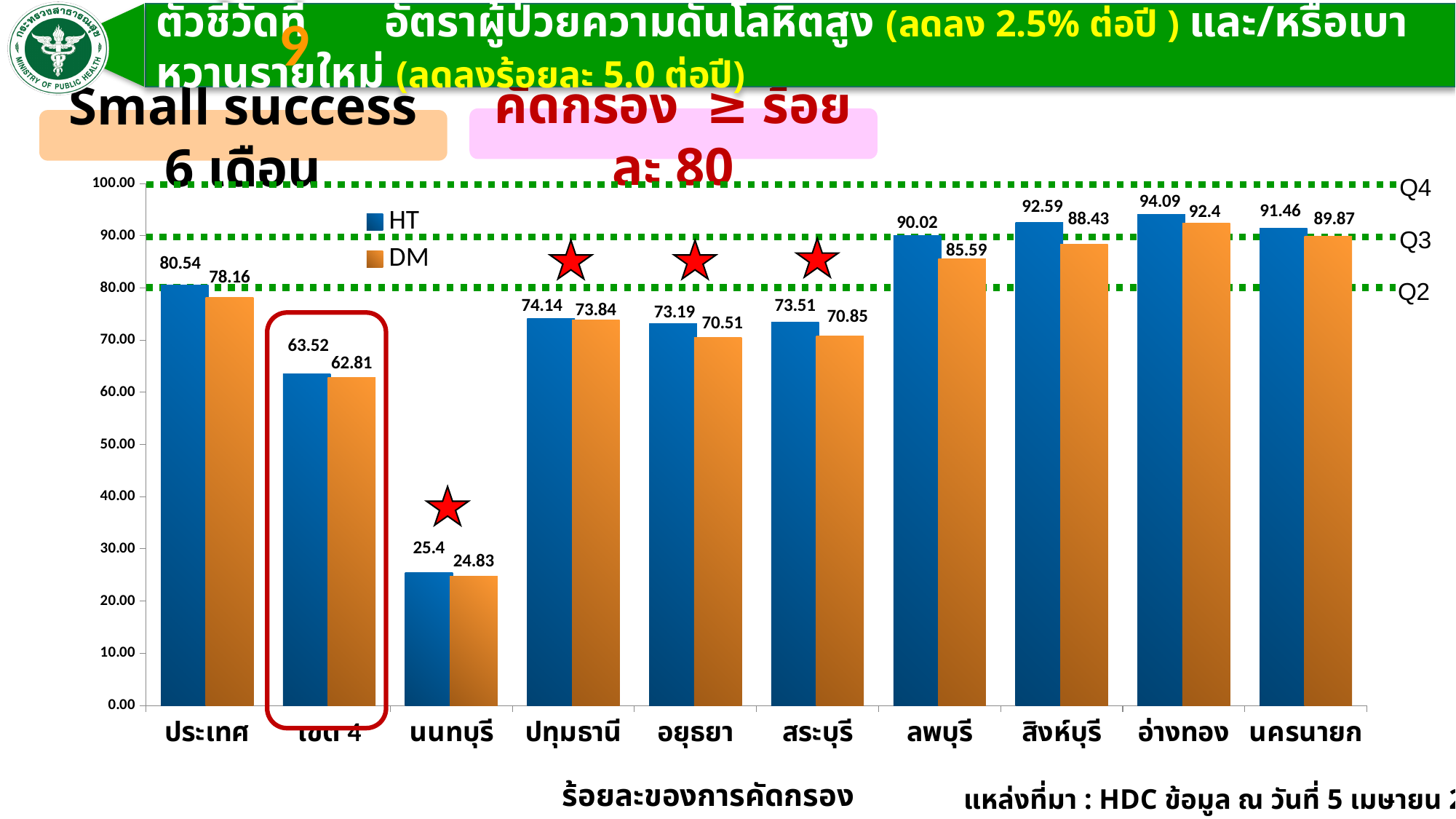
Is the DM value for เขต 4 greater or less than 70? less Which is larger, the HT value for สิงห์บุรี or the HT value for นครนายก? สิงห์บุรี What is the HT value for อ่างทอง? 94.09 What is the difference between the HT and DM values for ลพบุรี? 4.43 What is the HT value for นนทบุรี? 25.4 How many series does the legend list? 2 Which category has the lowest DM value? นนทบุรี What are the two series named in the legend? HT and DM How many categories are shown on the x axis? 10 What kind of chart is shown on the slide? bar chart Which category has the highest HT value? อ่างทอง What is the DM value for ลพบุรี? 85.59